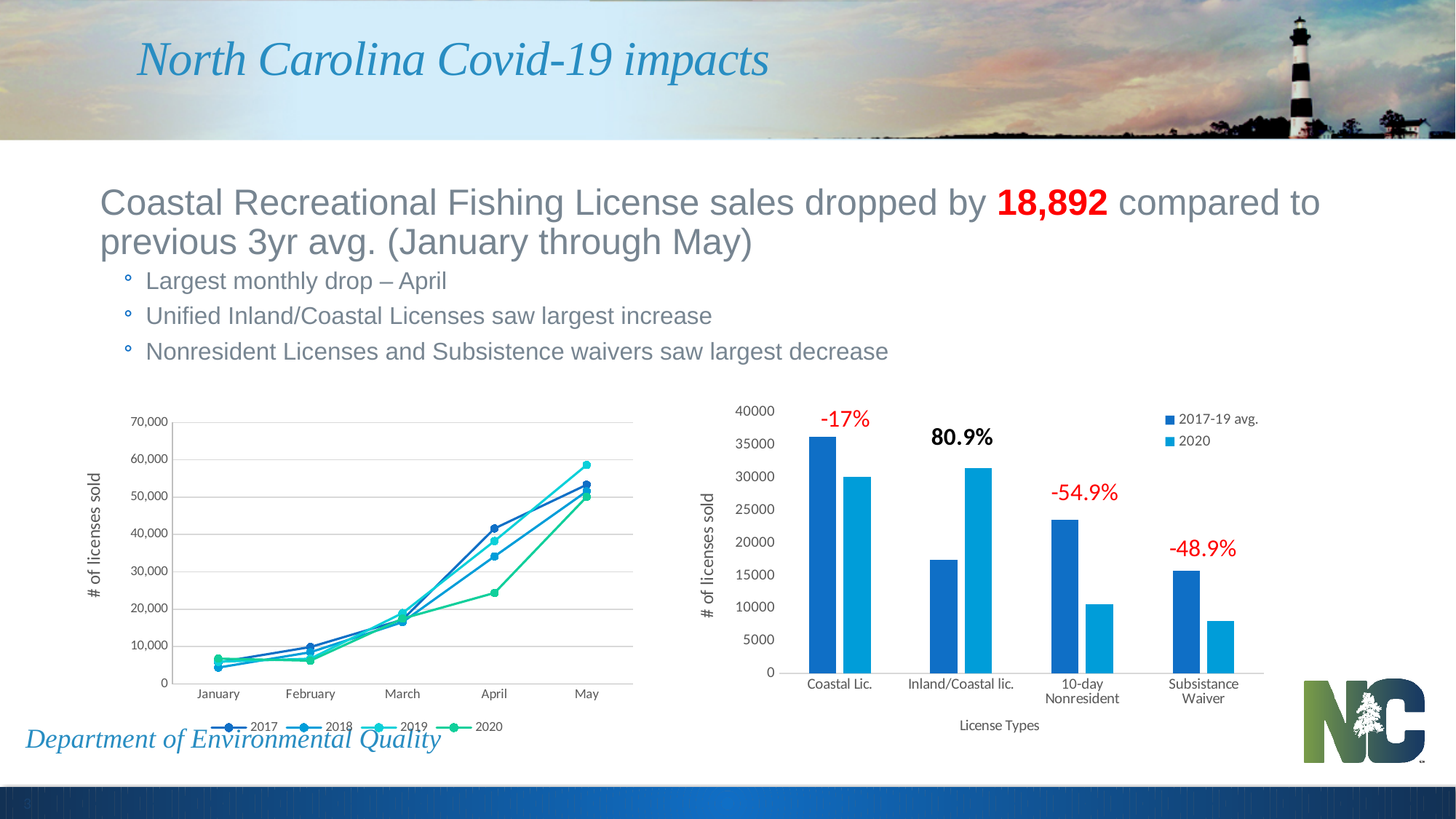
In the left chart, do the number of licenses sold rise or fall from January to May? rise What kind of chart is the chart on the right of the slide? bar chart In the left chart, which is larger for April: the 2017 value or the 2020 value? 2017 In the right chart, what percentage change is labelled above the Inland/Coastal lic. bars? 80.9% In the right chart, is the 2020 value for Subsistance Waiver greater or less than 10000? less How many months are shown on the x axis of the left chart? 5 In the left chart, is the 2020 value for April greater or less than 30,000? less How many series does the legend of the right chart list? 2 What kind of chart is the chart on the left of the slide? line chart In the right chart, what percentage change is labelled above the 10-day Nonresident bars? -54.9% How many series does the legend of the left chart list? 4 In the right chart, which license type has the highest 2017-19 avg. value? Coastal Lic.